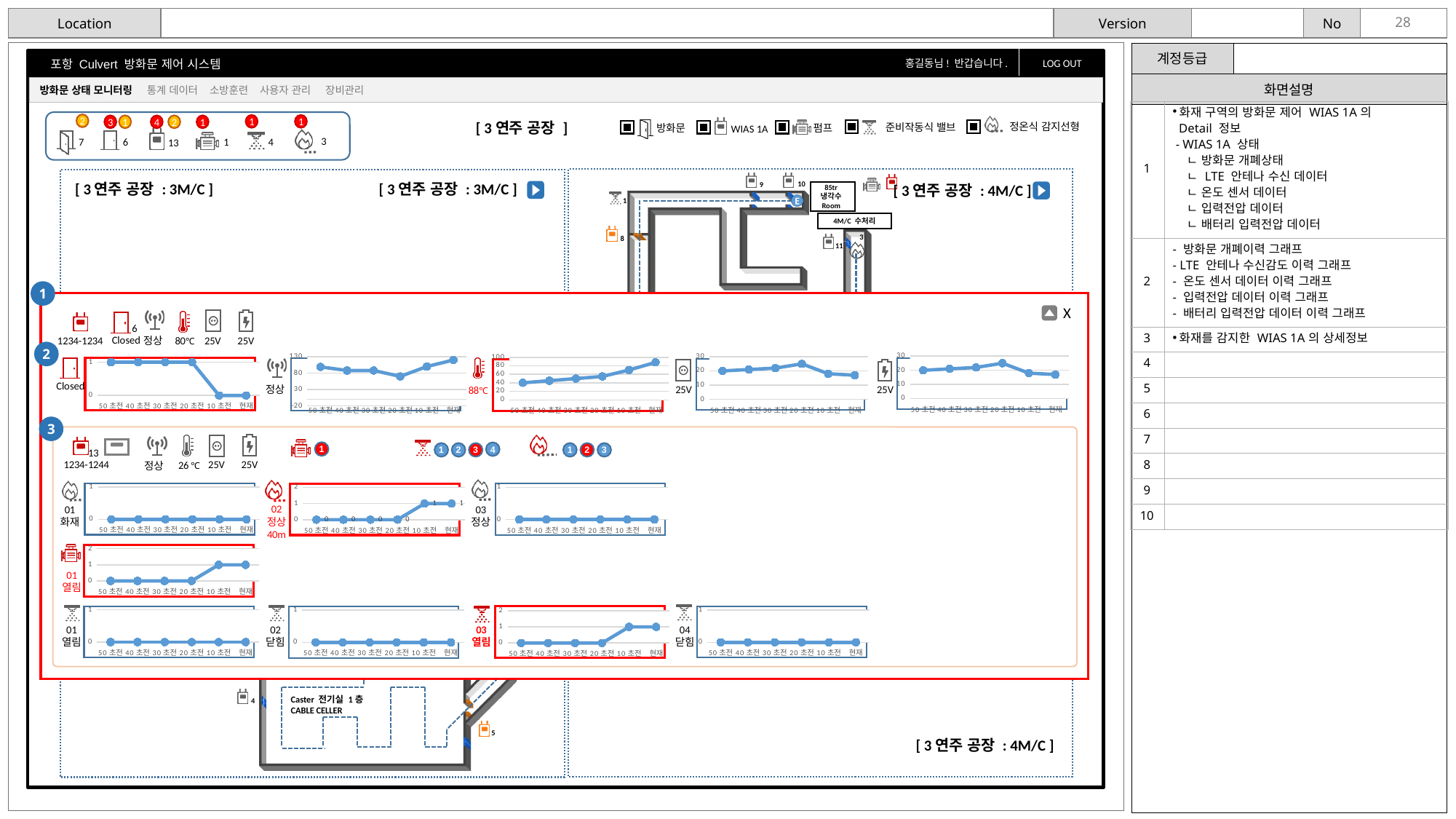
In the LTE antenna chart labelled 정상 in the second row, is the value at 20 초전 greater or less than 80? less In the temperature chart labelled 88℃, is the value at 현재 greater or less than 60? greater What kind of chart is the temperature chart labelled 88℃ in the second row of the detail panel? line chart In the door status chart labelled Closed in the second row, do the values rise or fall from 50 초전 to 현재? fall In the temperature chart labelled 88℃, is the value at 50 초전 greater or less than 60? less What is the top value shown on the y axis of the temperature chart labelled 88℃? 100 In the chart labelled 02 정상 40m, what is the value at 50 초전? 0 In the temperature chart labelled 88℃, which time point has the highest value? 현재 In the chart labelled 02 정상 40m, what is the value at 현재? 1 In the chart labelled 01 화재, what is the value at 현재? 0 In the temperature chart labelled 88℃, do the values rise or fall from 50 초전 to 현재? rise